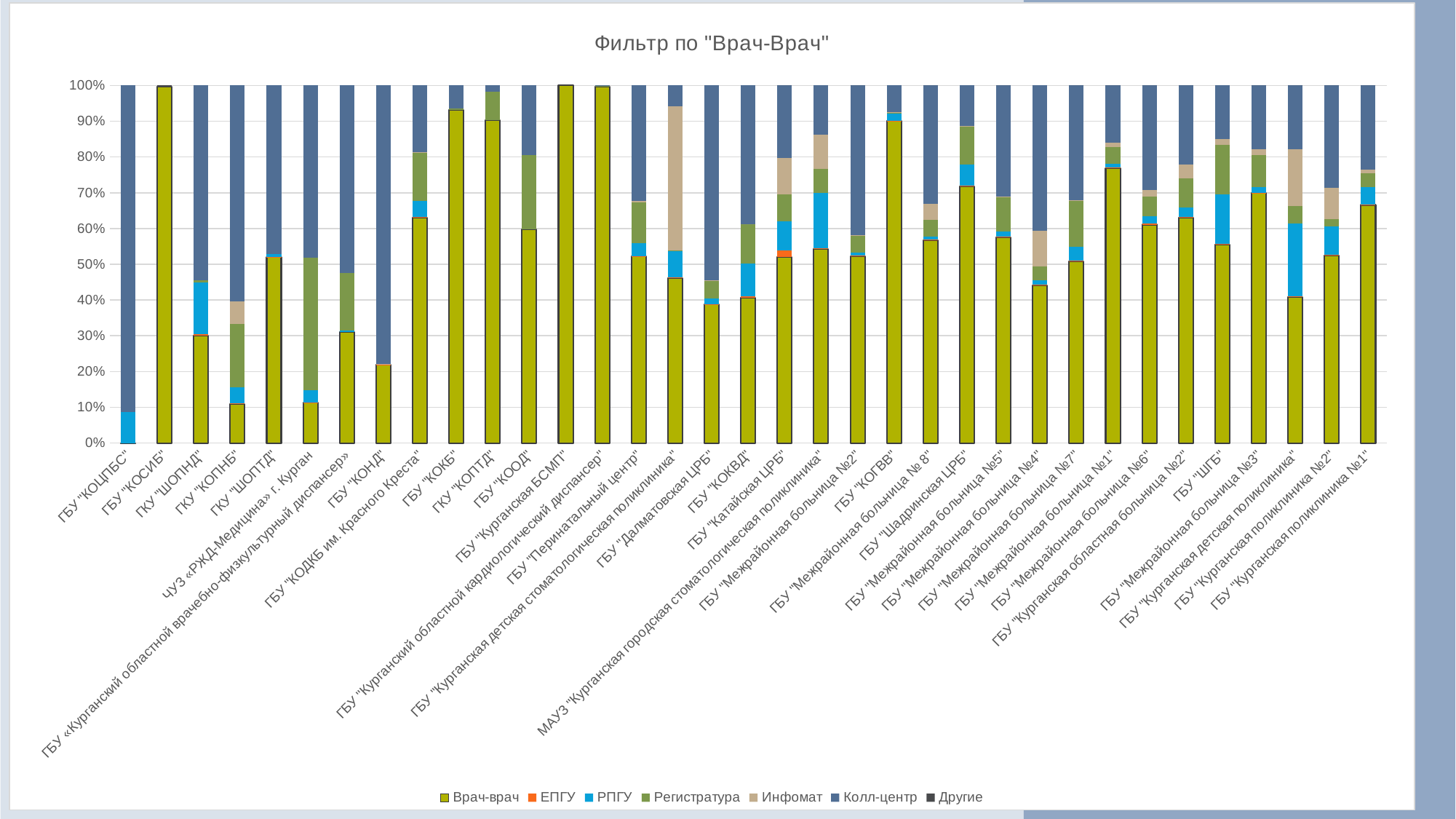
Is the Врач-врач share for ГКУ "КОПНБ" greater or less than 20%? less What kind of chart is shown on the slide? Stacked bar chart Is the Врач-врач share for ГБУ "КОКБ" greater or less than 90%? greater Is the Колл-центр share for ГБУ "КОЦПБС" greater or less than 80%? greater Which has the larger Врач-врач share: ГБУ "КОКБ" or ГБУ "КОНД"? ГБУ "КОКБ" What is the Врач-врач share for ГБУ "КОСИБ"? 100% How many series does the legend list? 7 What is the title of the chart? Фильтр по "Врач-Врач" How many organisations (categories) are shown on the x axis? 35 Which organisation has the lowest Врач-врач share? ГБУ "КОЦПБС"